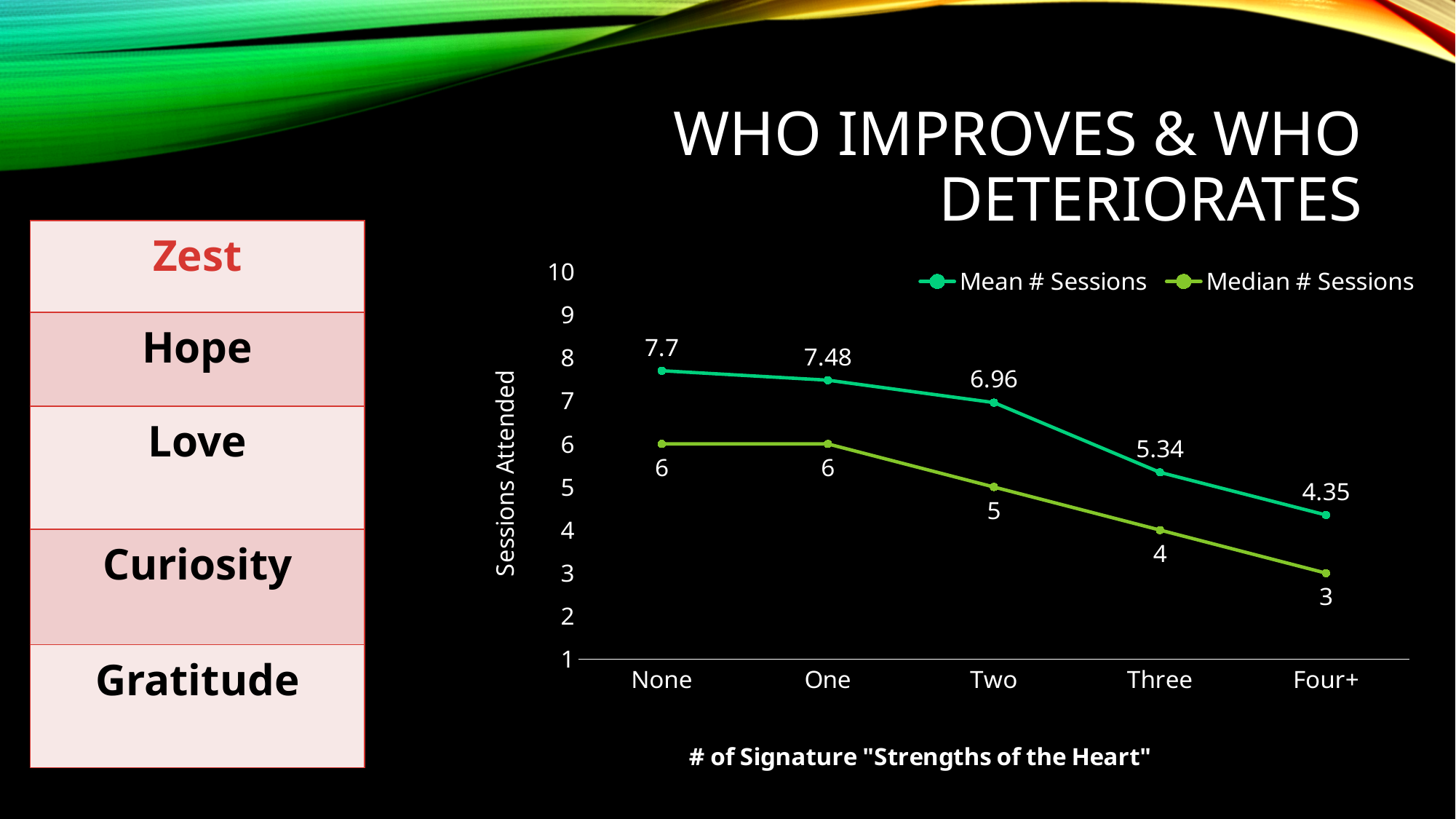
What is the Mean # Sessions value for the "Two" category? 6.96 What kind of chart is shown on the slide? Line chart Which category has the highest Mean # Sessions value? None Which category has the lowest Median # Sessions value? Four+ How many categories are shown on the x axis? 5 Do the Mean # Sessions values rise or fall from "None" to "Four+"? Fall What is the label of the y axis? Sessions Attended What is the difference between the Mean # Sessions values for "None" and "Four+"? 3.35 What is the Median # Sessions value for the "Four+" category? 3 Which is larger: the Mean # Sessions for "Three" or the Median # Sessions for "Three"? Mean # Sessions What is the Mean # Sessions value for the "None" category? 7.7 How many series does the legend list? 2